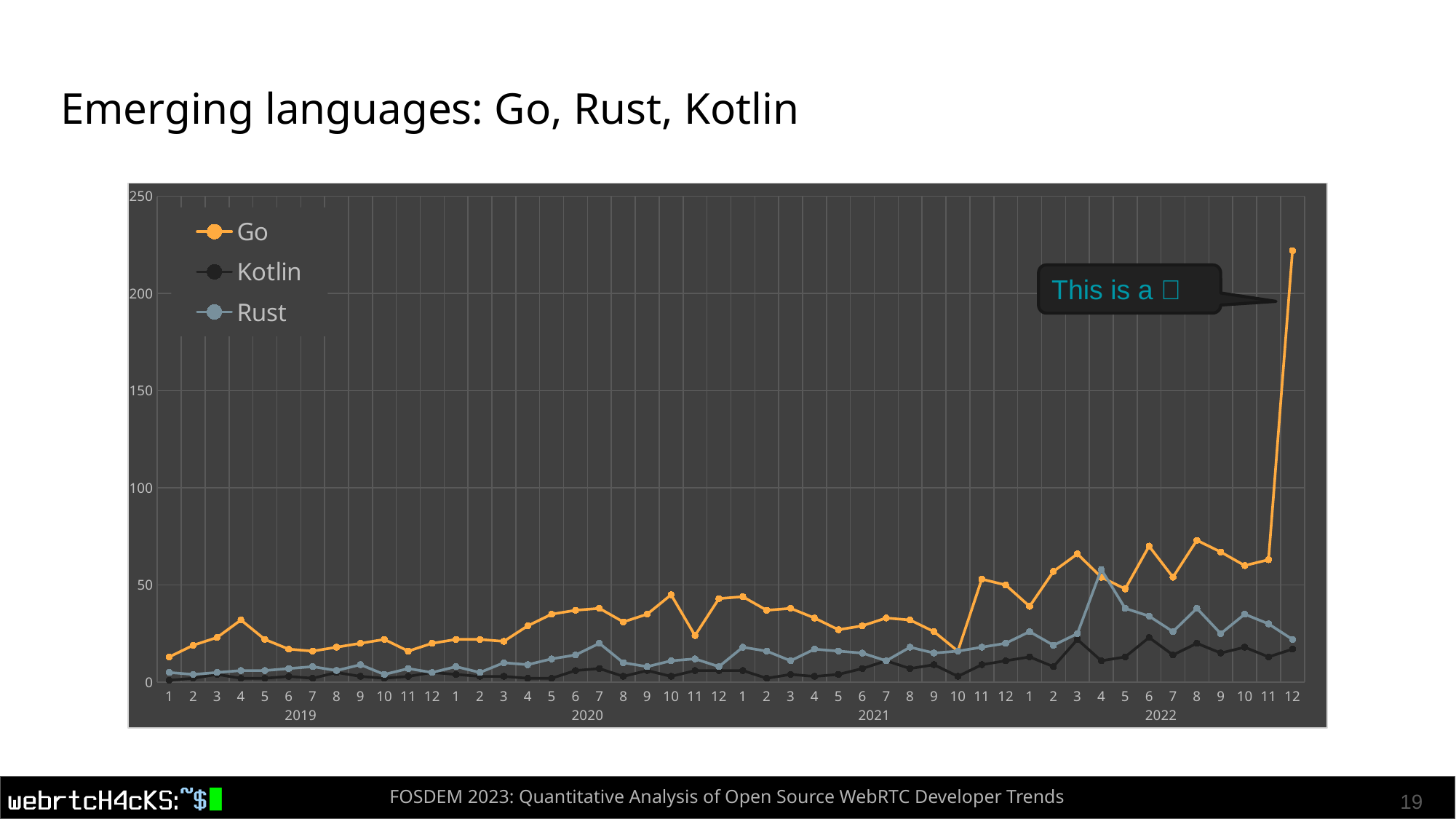
In which month and year does the Go series reach its peak? December 2022 Which series is drawn in orange? Go Is the value for Go in month 10 of 2020 greater or less than 50? less Is the value for Rust in month 4 of 2022 greater or less than 50? greater How many series does the legend list? 3 Which series reaches the highest value on the chart? Go Which series has the lowest values for most of the chart? Kotlin Which languages are listed in the chart legend? Go, Kotlin, Rust In month 12 of 2022, which series has the larger value, Go or Rust? Go What kind of chart is shown on the slide? line chart Is the value for Go in month 12 of 2022 greater or less than 200? greater